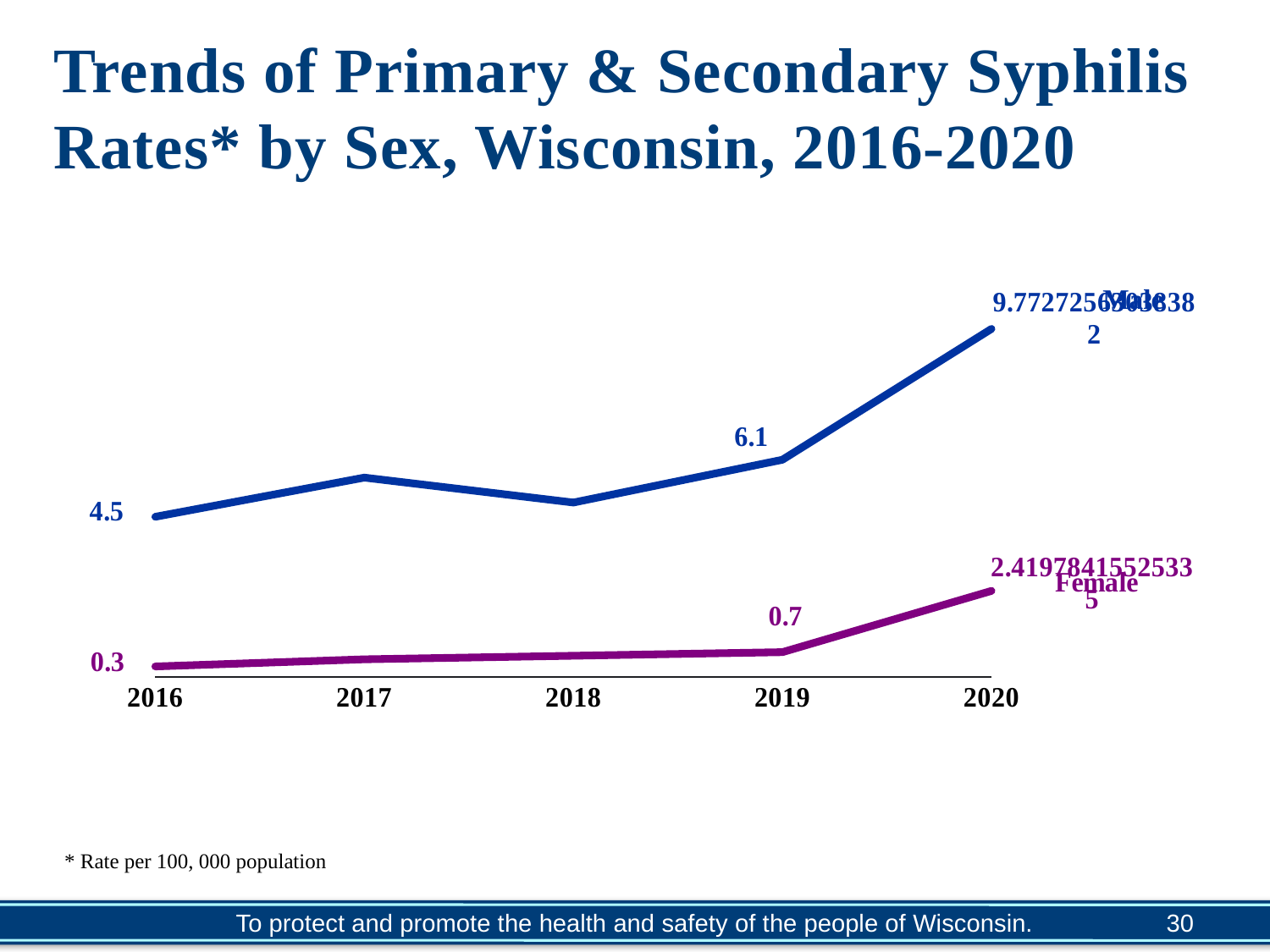
In which year was the Male rate lowest? 2016 Which series is plotted in blue? Male How many years are shown on the x axis of the chart? 5 What was the Female rate in 2019? 0.7 What was the Male primary and secondary syphilis rate in 2016? 4.5 How many series does the chart plot? 2 What type of chart is shown on the slide? Line chart What was the Male rate in 2019? 6.1 In which year was the Male rate highest? 2020 What was the Female rate in 2016? 0.3 By how much did the Male rate increase from 2016 to 2019? 1.6 What is the difference between the Male and Female rates in 2019? 5.4